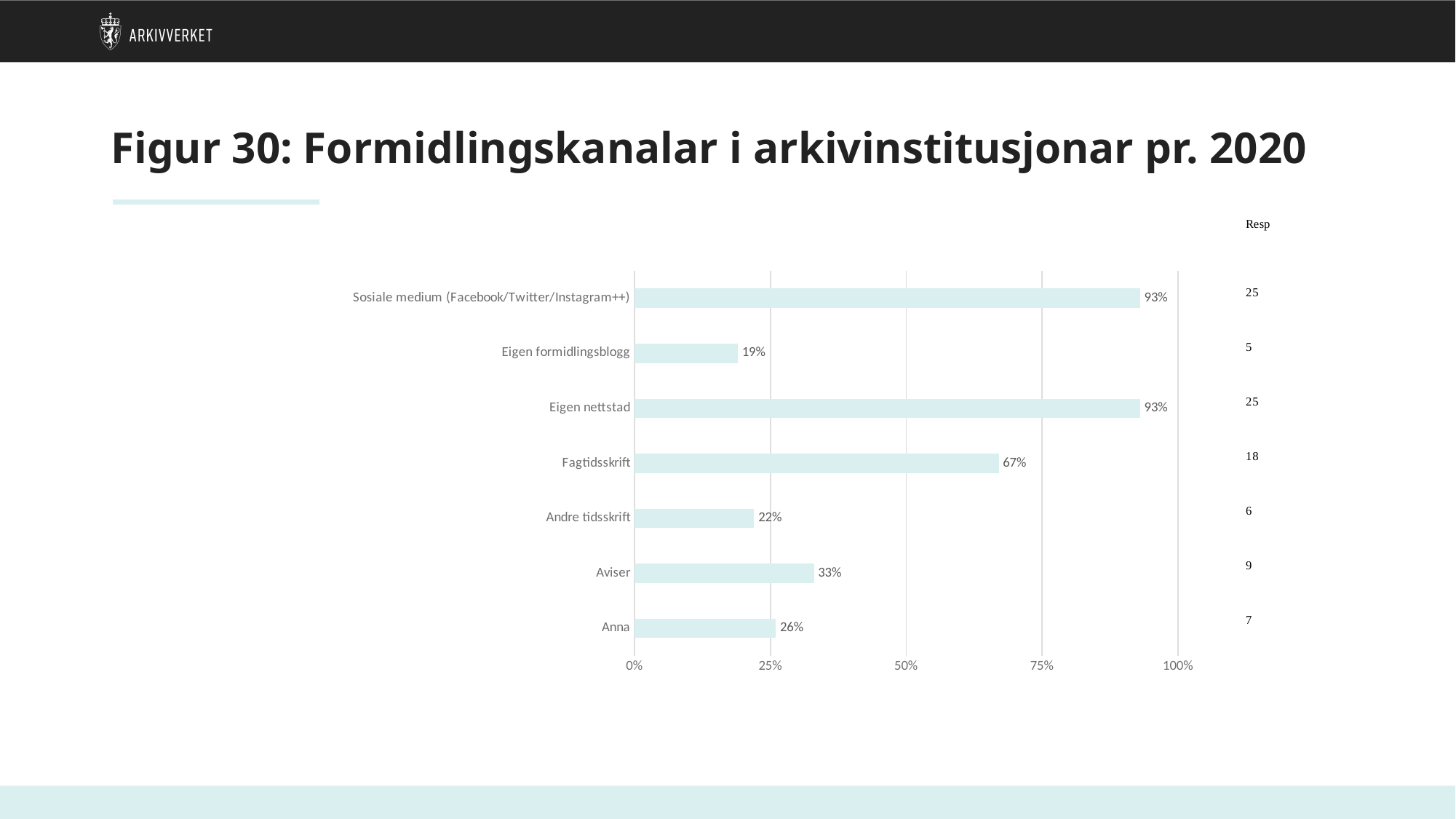
What is the value for Aviser? 33% What is the title of the slide? Figur 30: Formidlingskanalar i arkivinstitusjonar pr. 2020 Which is larger, the value for Aviser or the value for Andre tidsskrift? Aviser What is the value for Fagtidsskrift? 67% Is the value for Fagtidsskrift greater or less than 50%? greater What is the difference between the values for Anna and Andre tidsskrift? 4% What kind of chart is shown on the slide? bar chart What is the value for Anna? 26% How many categories are shown in the chart? 7 Which category has the lowest value? Eigen formidlingsblogg What is the difference between the values for Fagtidsskrift and Aviser? 34% What is the value for Eigen formidlingsblogg? 19%